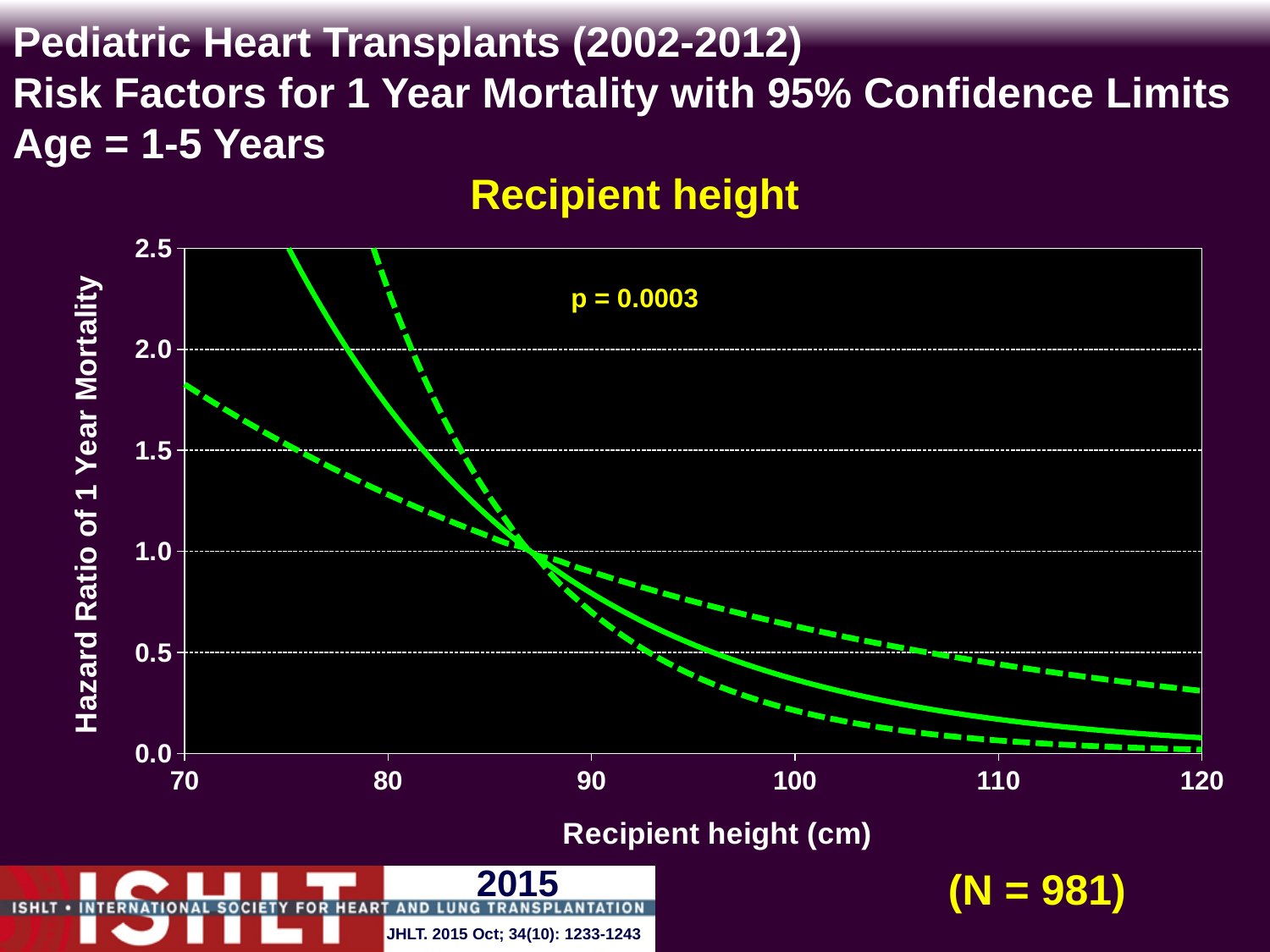
Does the hazard ratio of 1 year mortality rise or fall as recipient height increases from 70 cm to 120 cm? fall Is the upper 95% confidence limit (upper dashed line) at a recipient height of 100 cm greater or less than 0.5? greater What is the label of the x axis of the chart? Recipient height (cm) What p-value is printed on the chart? p = 0.0003 Is the hazard ratio (solid line) at a recipient height of 80 cm greater or less than 1.5? greater What kind of chart is shown on the slide? line chart Is the hazard ratio at 80 cm larger or smaller than the hazard ratio at 100 cm? larger Is the hazard ratio (solid line) at a recipient height of 110 cm greater or less than 0.5? less How many lines are plotted on the chart? 3